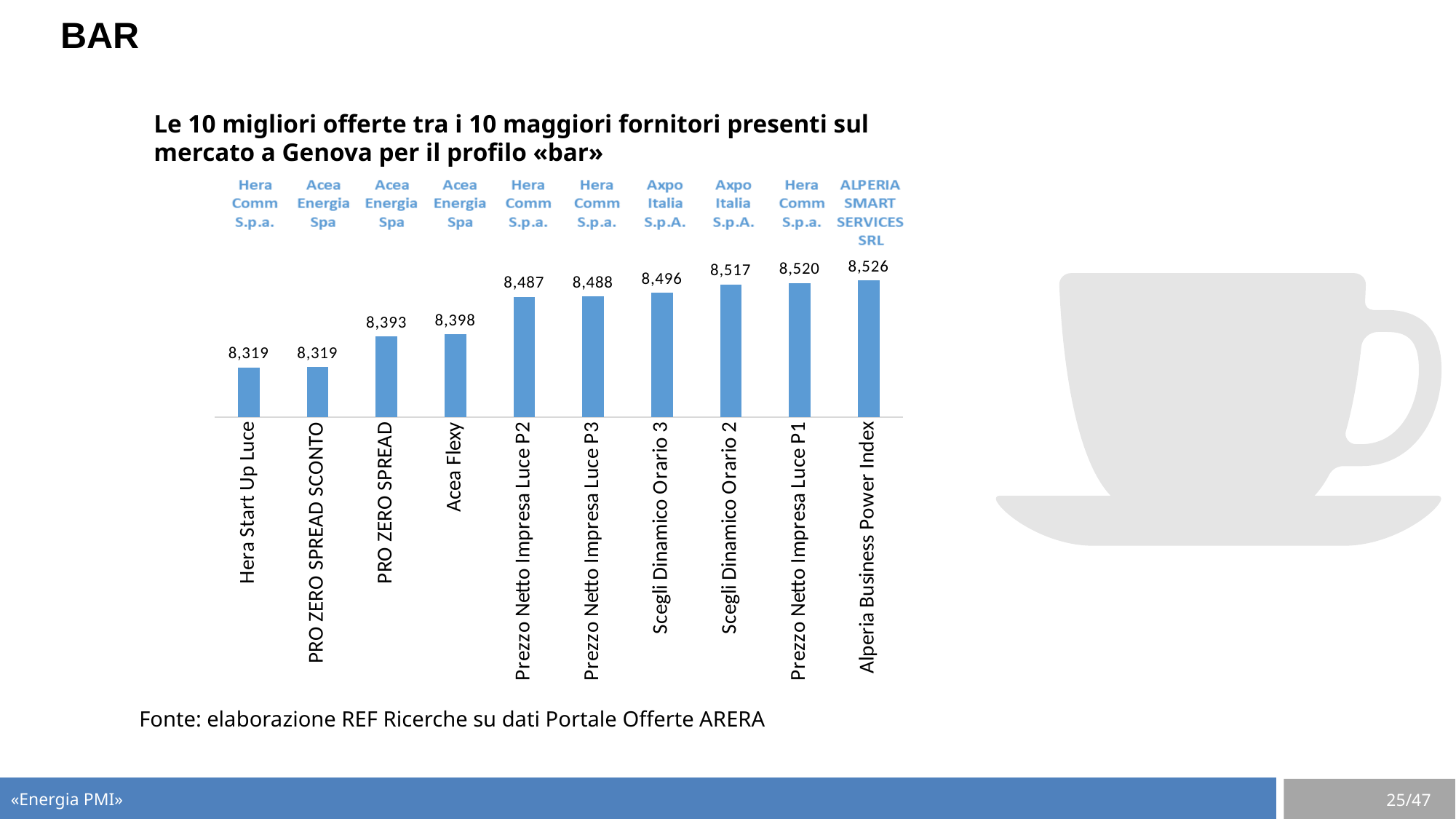
Which offer has the highest value in the chart? Alperia Business Power Index What is the value shown for Scegli Dinamico Orario 3? 8,496 Which supplier is listed above the Alperia Business Power Index bar? ALPERIA SMART SERVICES SRL What is the lowest value shown in the chart? 8,319 What kind of chart is shown on the slide? bar chart What is the source cited below the chart? elaborazione REF Ricerche su dati Portale Offerte ARERA Which has the larger value, Scegli Dinamico Orario 2 or Prezzo Netto Impresa Luce P3? Scegli Dinamico Orario 2 What is the value shown for Prezzo Netto Impresa Luce P1? 8,520 Do the values rise or fall from left to right across the chart? rise What is the difference between the values for Alperia Business Power Index and Hera Start Up Luce? 0,207 How many offers (bars) are plotted in the chart? 10 What is the value shown for Acea Flexy? 8,398